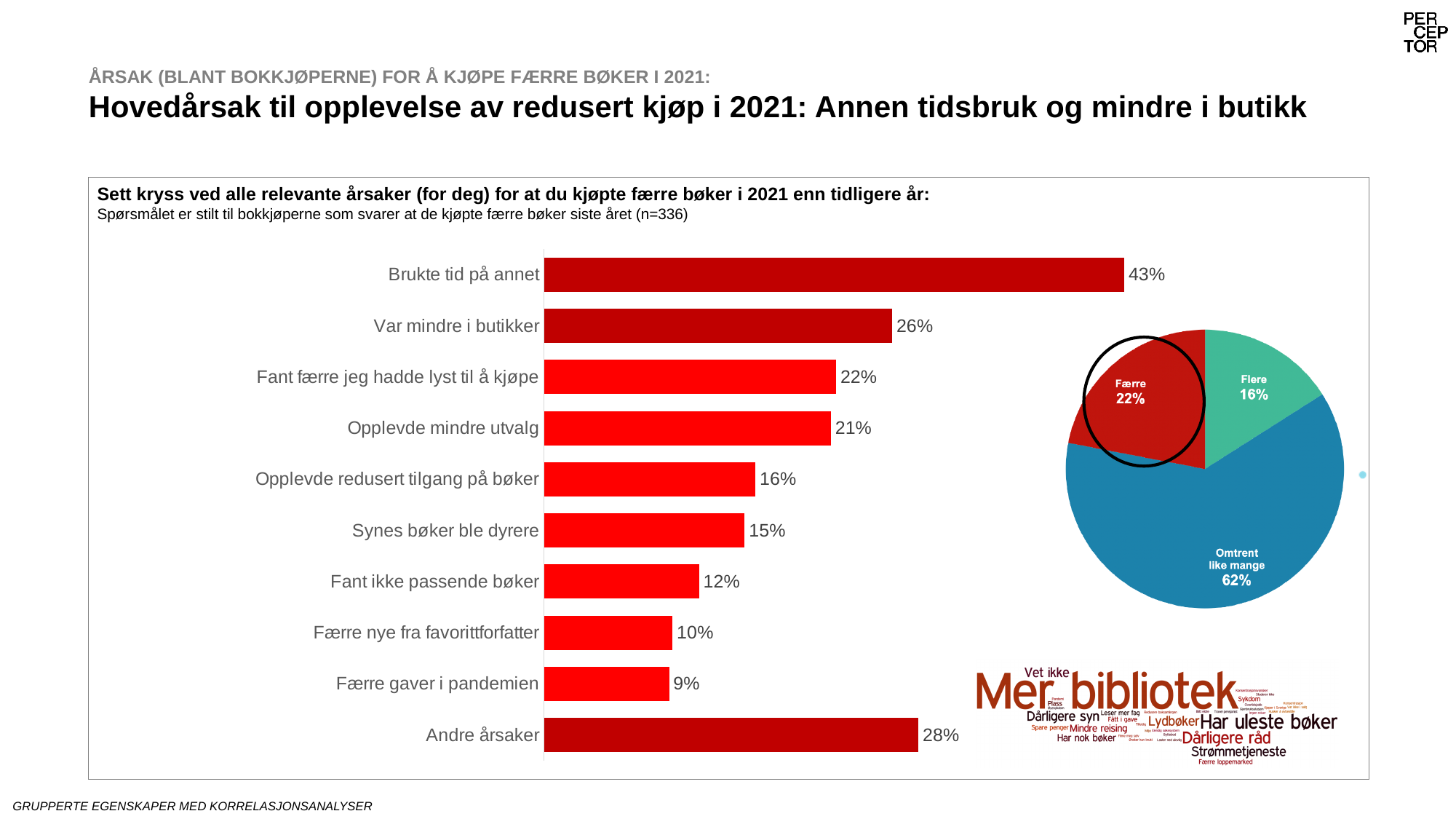
What kind of chart is the chart on the left of the slide? Bar chart In the bar chart, what is the value for "Færre gaver i pandemien"? 9% In the bar chart, which category has the highest value? Brukte tid på annet How many slices does the pie chart have? 3 In the bar chart, which is larger: "Andre årsaker" or "Var mindre i butikker"? Andre årsaker In the bar chart, which category has the lowest value? Færre gaver i pandemien In the pie chart, what is the share for "Omtrent like mange"? 62% In the bar chart, what is the difference between "Var mindre i butikker" and "Synes bøker ble dyrere"? 11% In the bar chart, what is the value for "Brukte tid på annet"? 43% In the pie chart, which slice is the smallest? Flere In the pie chart, what is the value for "Flere"? 16% How many categories does the bar chart show? 10